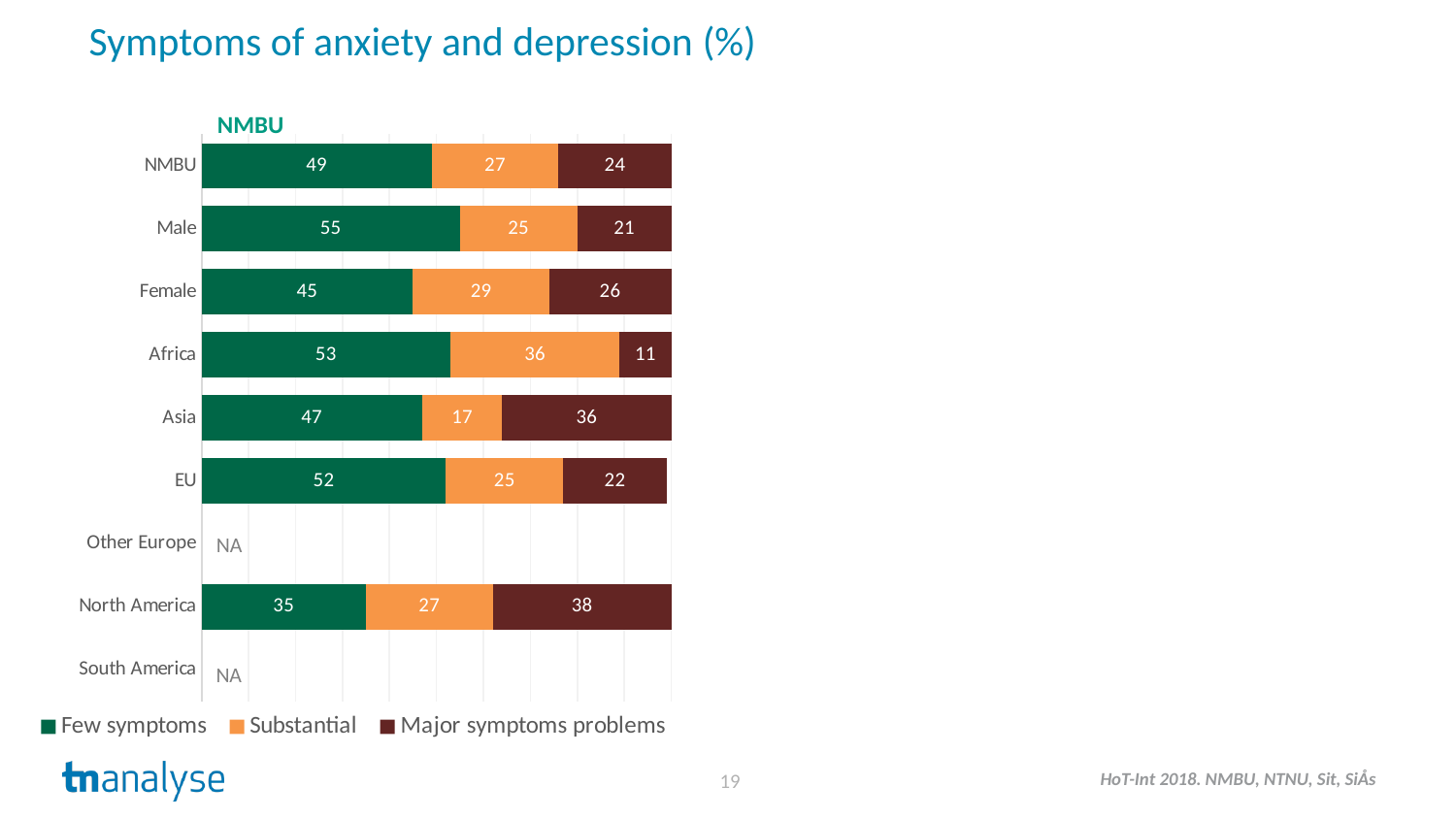
Which is larger, the Major symptoms problems value for North America or for EU? North America What kind of chart is shown on the slide? Stacked bar chart What is the value for Major symptoms problems for Asia? 36 How many series does the legend list? 3 What is the title shown above the chart? NMBU Which category has the lowest value for Major symptoms problems? Africa What is the difference between the Few symptoms values for Male and Female? 10 What is the total of the stacked bar for NMBU? 100 What is the value for Substantial for Africa? 36 Which categories are shown as NA? Other Europe and South America Which category has the highest value for Few symptoms? Male What is the value for Few symptoms for Male? 55